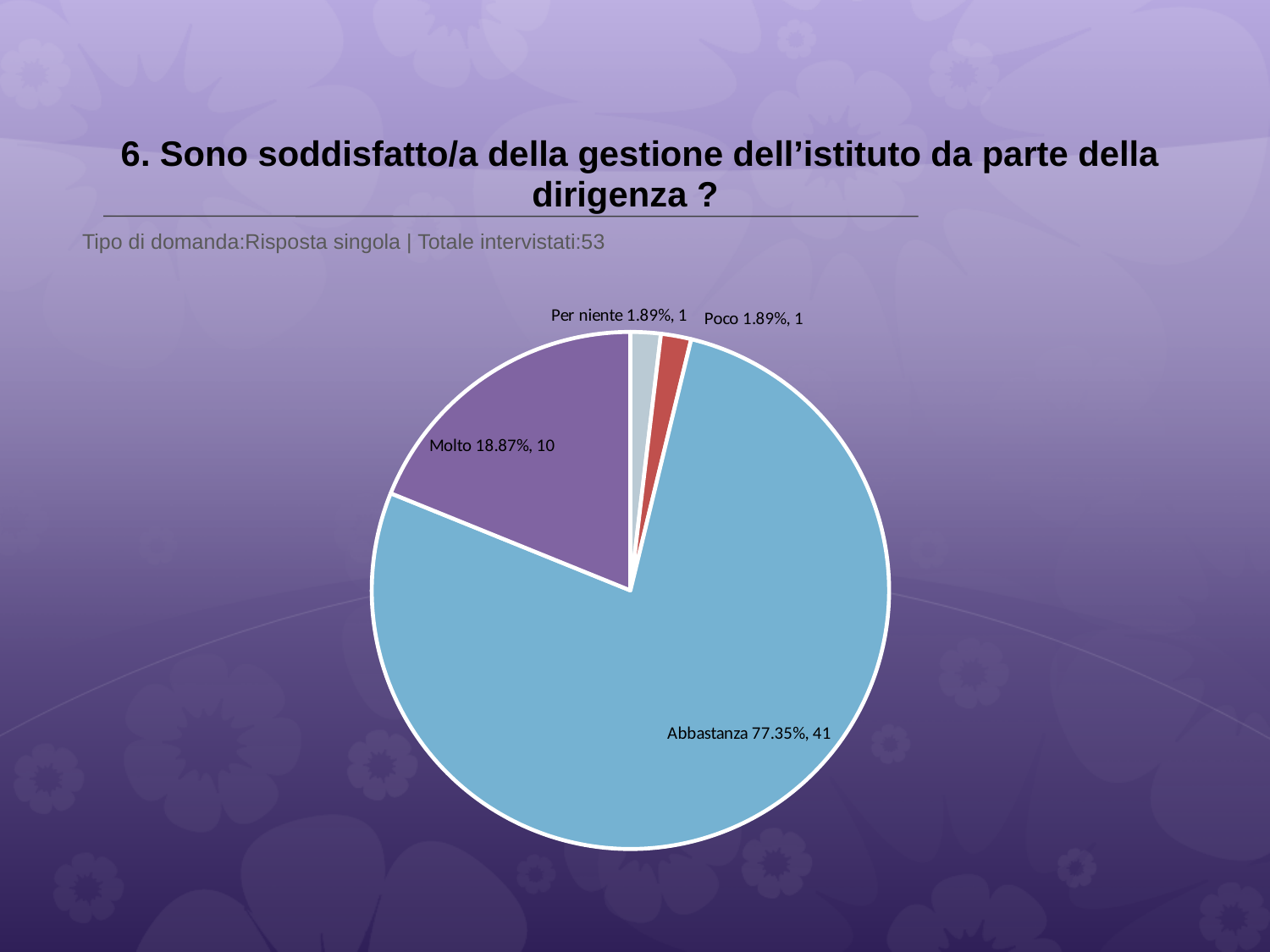
What percentage of respondents answered "Abbastanza"? 77.35% What percentage of respondents answered "Molto"? 18.87% How many slices does the pie chart have? 4 What kind of chart is shown on the slide? pie chart How many respondents answered "Poco"? 1 What is the difference in number of respondents between "Abbastanza" and "Molto"? 31 Which has more respondents, "Molto" or "Poco"? Molto Which response category has the largest slice of the pie? Abbastanza How many respondents answered "Molto"? 10 What colour is the "Abbastanza" slice of the pie? light blue What is the total number of respondents shown across all slices of the pie? 53 What percentage of respondents answered "Per niente"? 1.89%